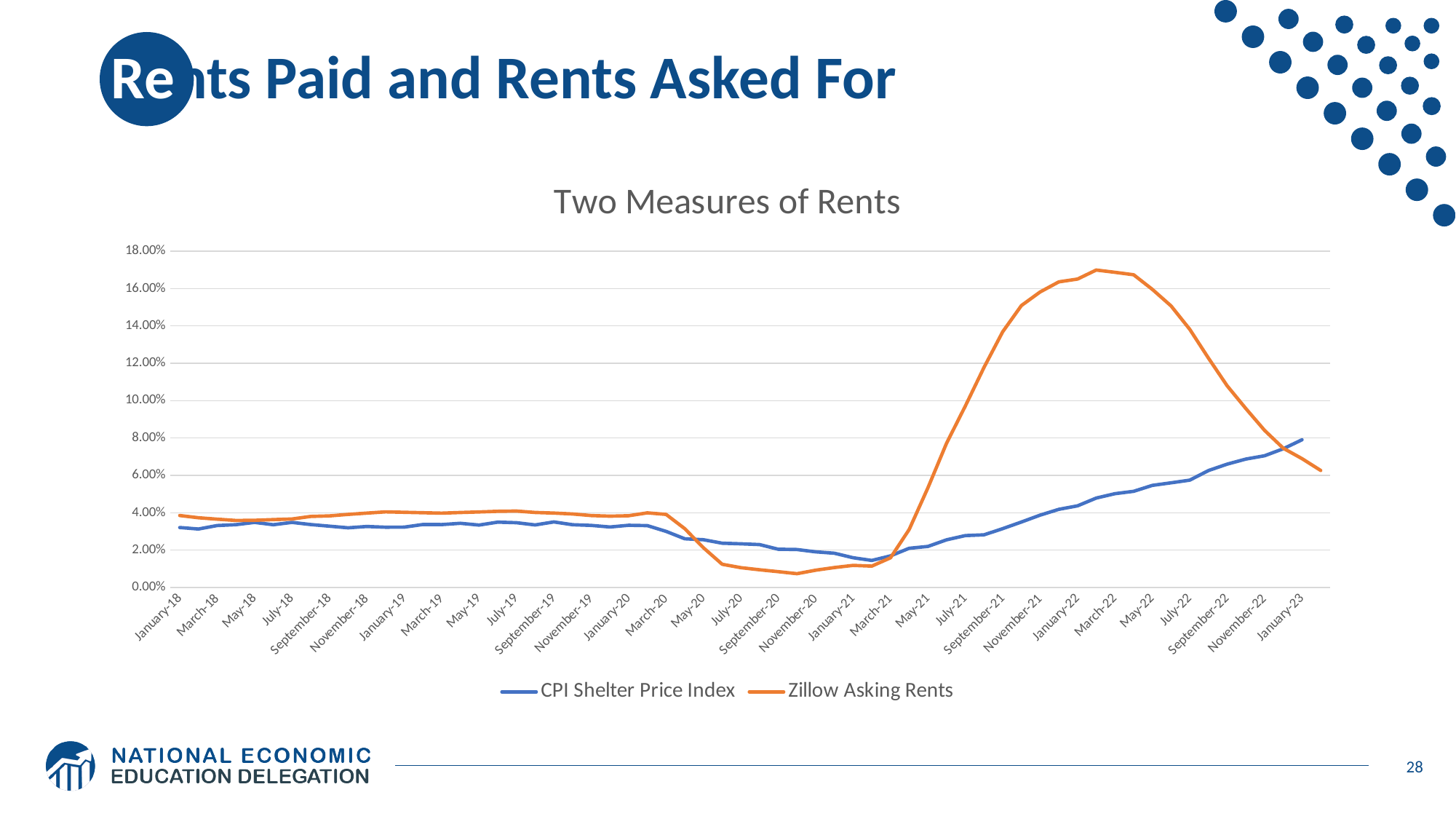
Is the value for Zillow Asking Rents in March-22 greater or less than 16.00%? greater How many series does the legend list? 2 Is the value for CPI Shelter Price Index in January-23 greater or less than 6.00%? greater What is the title of the chart? Two Measures of Rents Is the value for CPI Shelter Price Index in January-18 greater or less than 4.00%? less Does the Zillow Asking Rents line rise or fall between March-22 and January-23? fall In January-23, which series has the higher value, CPI Shelter Price Index or Zillow Asking Rents? CPI Shelter Price Index In January-22, which series has the higher value, CPI Shelter Price Index or Zillow Asking Rents? Zillow Asking Rents What kind of chart is shown on the slide? line chart Which two series are listed in the chart legend? CPI Shelter Price Index and Zillow Asking Rents Which series reaches the highest value anywhere on the chart? Zillow Asking Rents